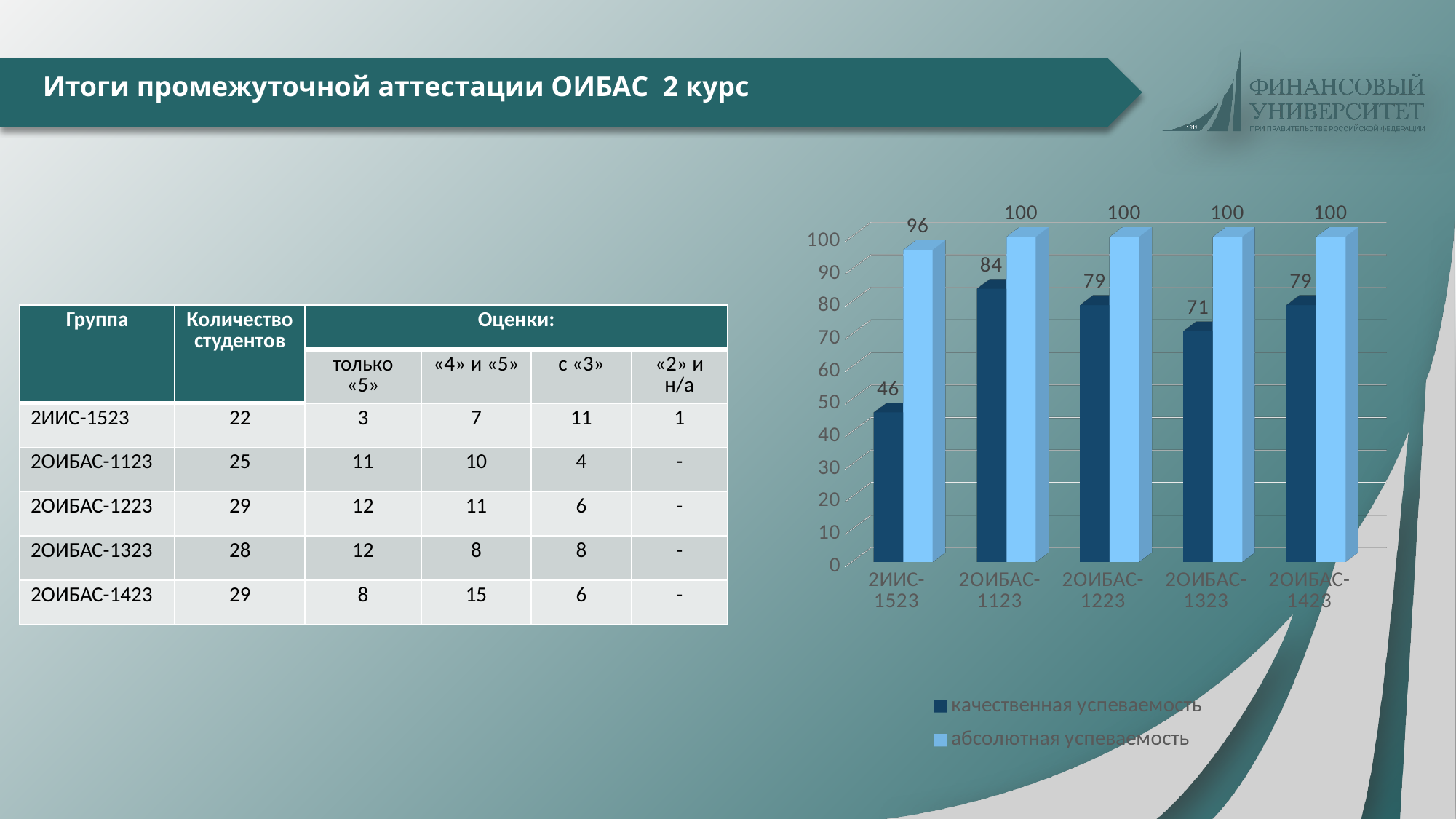
What is the value of качественная успеваемость for 2ОИБАС-1323? 71 Which is larger: качественная успеваемость for 2ОИБАС-1223 or for 2ОИБАС-1323? 2ОИБАС-1223 How many groups are shown on the x axis of the chart? 5 Which group has the lowest качественная успеваемость? 2ИИС-1523 How many series does the chart legend list? 2 What is the difference between качественная успеваемость for 2ОИБАС-1123 and 2ИИС-1523? 38 Which group has the highest качественная успеваемость? 2ОИБАС-1123 What is the value of качественная успеваемость for 2ИИС-1523? 46 Which group has абсолютная успеваемость below 100? 2ИИС-1523 Which colour represents абсолютная успеваемость in the chart? light blue What is the value of абсолютная успеваемость for 2ИИС-1523? 96 What kind of chart is shown on the slide? bar chart